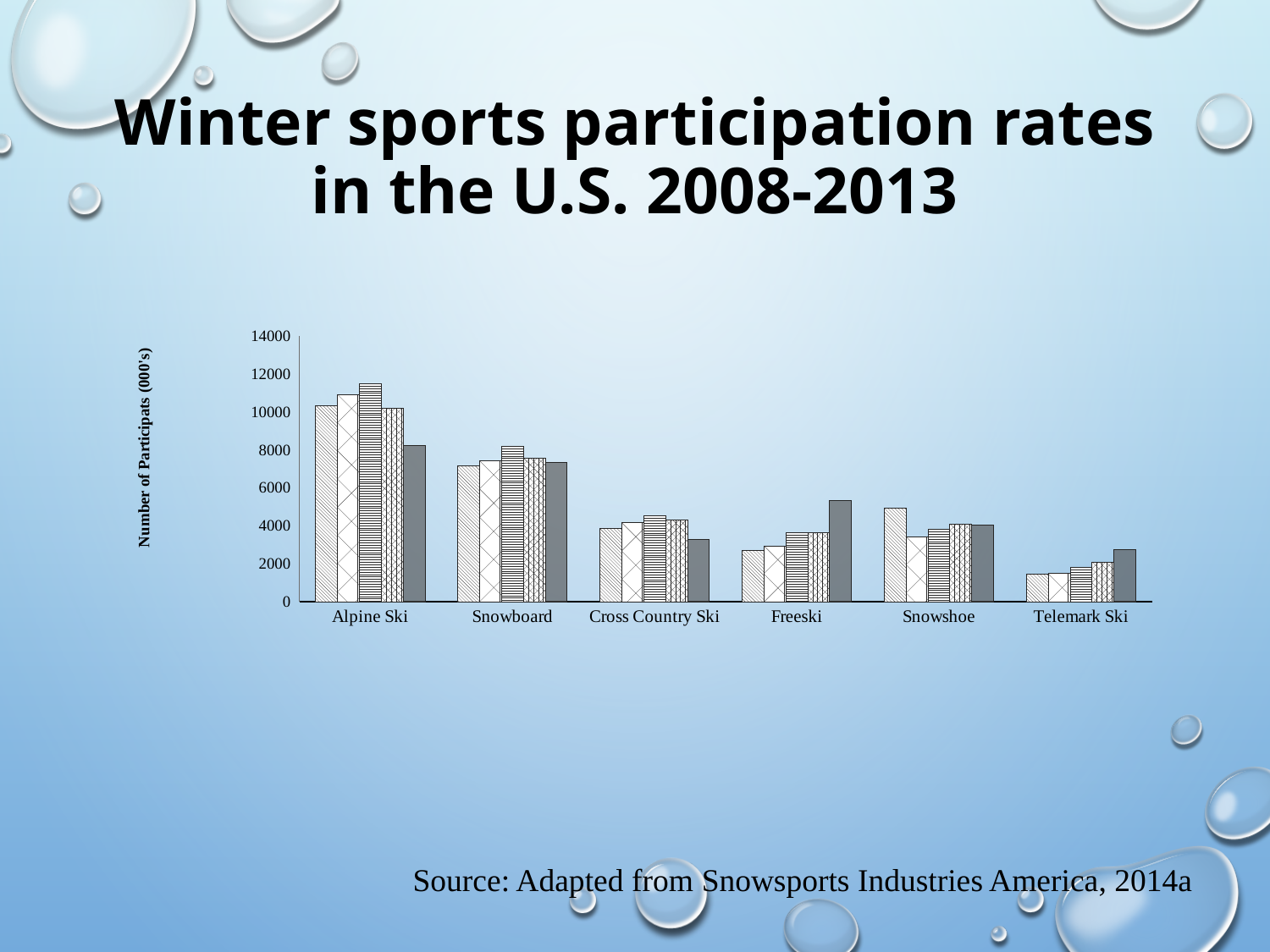
What kind of chart is shown on the slide? bar chart Which has the taller bars overall, Snowboard or Cross Country Ski? Snowboard How many bars are plotted for each sport category in the chart? 5 Is the tallest bar for Alpine Ski greater or less than 10000? greater Which sport category has the tallest bar in the chart? Alpine Ski How many sport categories are shown on the x axis of the chart? 6 Are all the bars for Snowboard greater or less than 6000? greater Are all the bars for Telemark Ski greater or less than 4000? less Which sport category has the shortest bars in the chart? Telemark Ski What is the label on the vertical axis of the chart? Number of Participats (000's) What is the highest value shown on the vertical axis of the chart? 14000